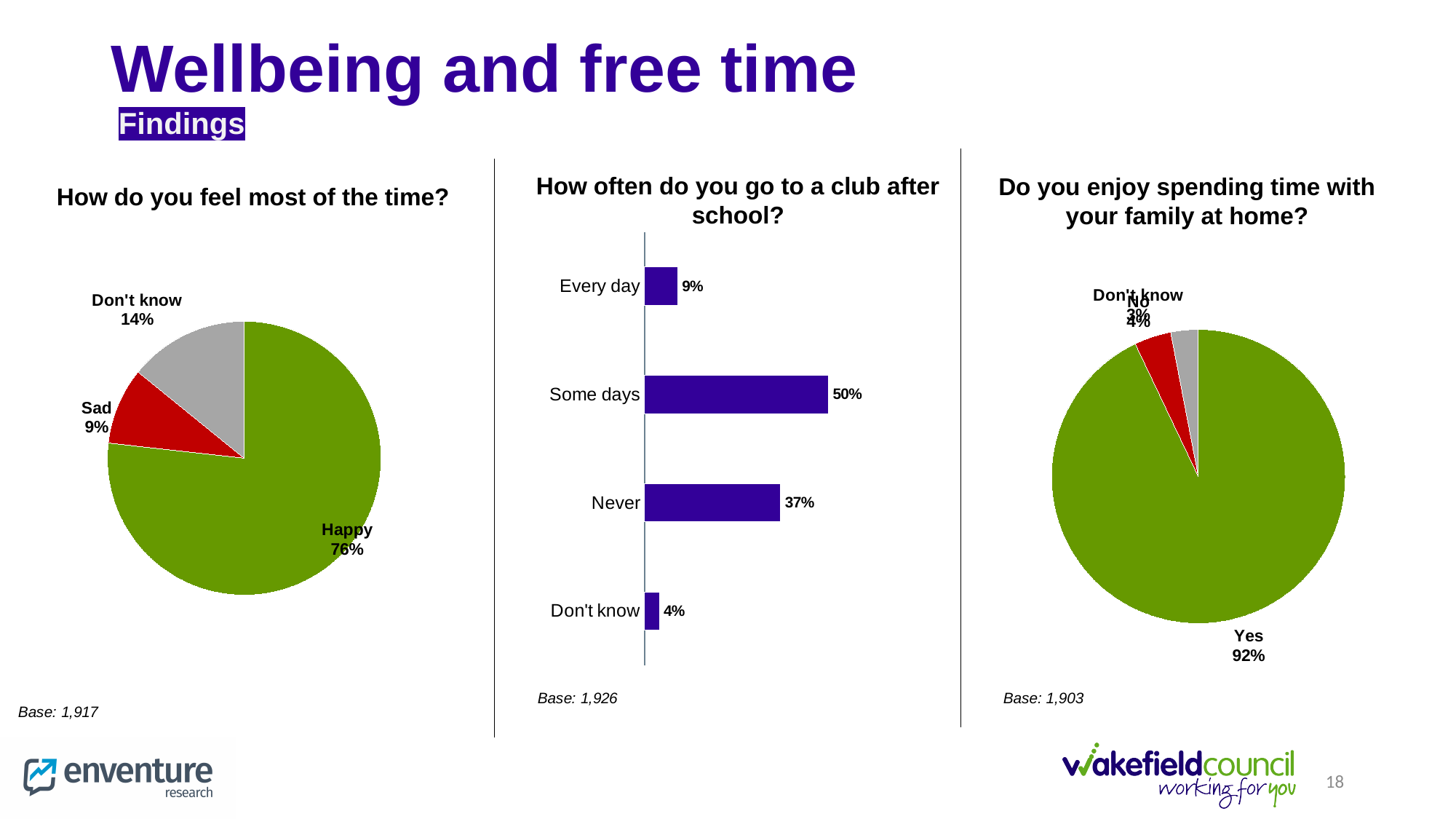
What is the base (number of respondents) shown for the 'Do you enjoy spending time with your family at home?' chart? 1,903 In the 'How do you feel most of the time?' chart, what percentage of respondents said Happy? 76% How many response categories are shown in the 'How often do you go to a club after school?' chart? 4 What type of chart is used for 'How often do you go to a club after school?' Bar chart In the 'How do you feel most of the time?' chart, what is the difference between the Happy and Don't know shares? 62 percentage points In the 'Do you enjoy spending time with your family at home?' chart, what percentage said Yes? 92% In the 'How do you feel most of the time?' chart, which response has the smallest share? Sad In the 'How do you feel most of the time?' chart, what percentage said Sad? 9% In the 'How often do you go to a club after school?' chart, what percentage said Some days? 50% In the 'How often do you go to a club after school?' chart, what is the difference between Some days and Never? 13 percentage points In the 'How often do you go to a club after school?' chart, which response has the highest value? Some days In the 'How often do you go to a club after school?' chart, which is larger: Every day or Never? Never